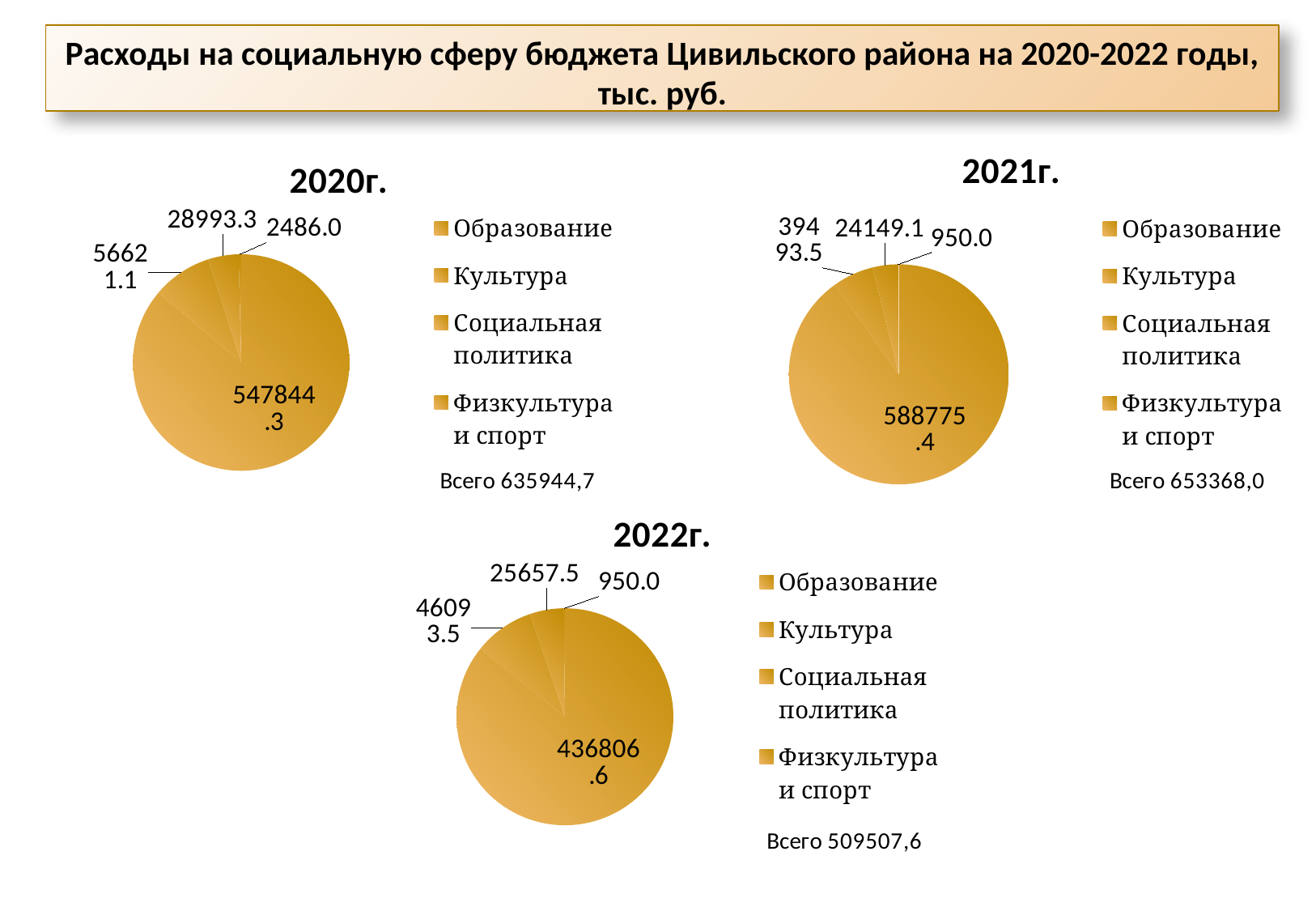
Which year has the highest total (Всего) shown on the slide? 2021г. In the 2020г. chart, what is the value of the largest slice? 547844.3 What total (Всего) is shown under the 2020г. chart? 635944,7 How many categories does the legend of the 2020г. chart list? 4 In the 2021г. chart, what is the value of the largest slice? 588775.4 In the 2020г. chart, which category has the largest slice? Образование Is the largest slice value in the 2021г. chart larger or smaller than the largest slice value in the 2020г. chart? Larger In the 2022г. chart, what is the value of the largest slice? 436806.6 How many pie charts are shown on the slide? 3 What kind of chart is used for each year on the slide? Pie chart In the 2020г. chart, what is the smallest labelled value? 2486.0 What total (Всего) is shown under the 2022г. chart? 509507,6